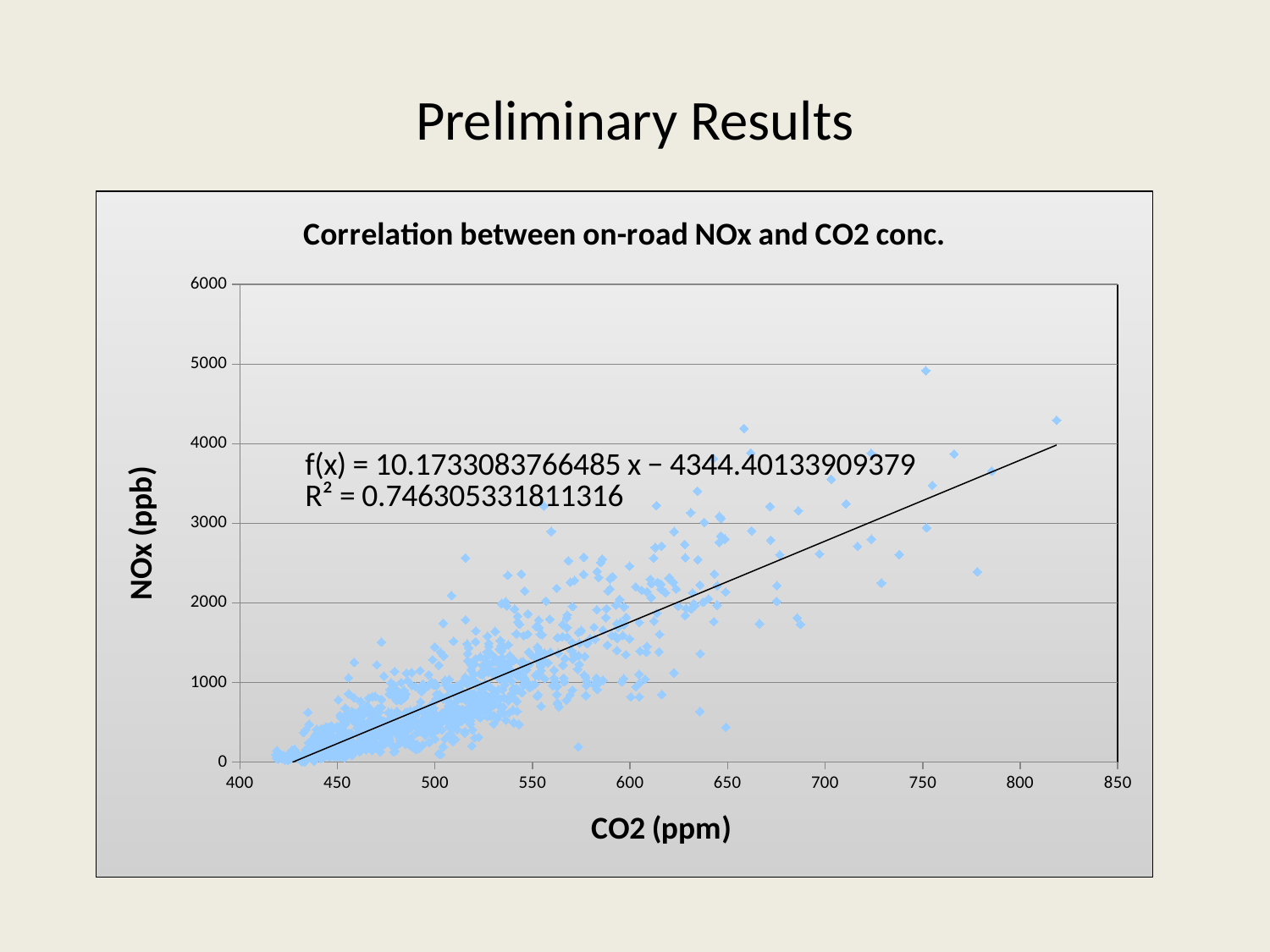
Is the largest CO2 value plotted greater or less than 800? greater What is the label of the x axis? CO2 (ppm) What is the title of the chart? Correlation between on-road NOx and CO2 conc. Do the NOx values generally rise or fall as CO2 increases along the x axis? rise What kind of chart is shown on the slide? scatter plot What is the intercept of the fitted line f(x) printed on the chart? −4344.40133909379 Is the highest NOx value plotted greater or less than 4000? greater Is the R² value of the trendline greater or less than 0.5? greater What is the slope of the fitted line f(x) printed on the chart? 10.1733083766485 What is the maximum value shown on the y axis? 6000 What R² value is printed on the chart for the trendline? 0.746305331811316